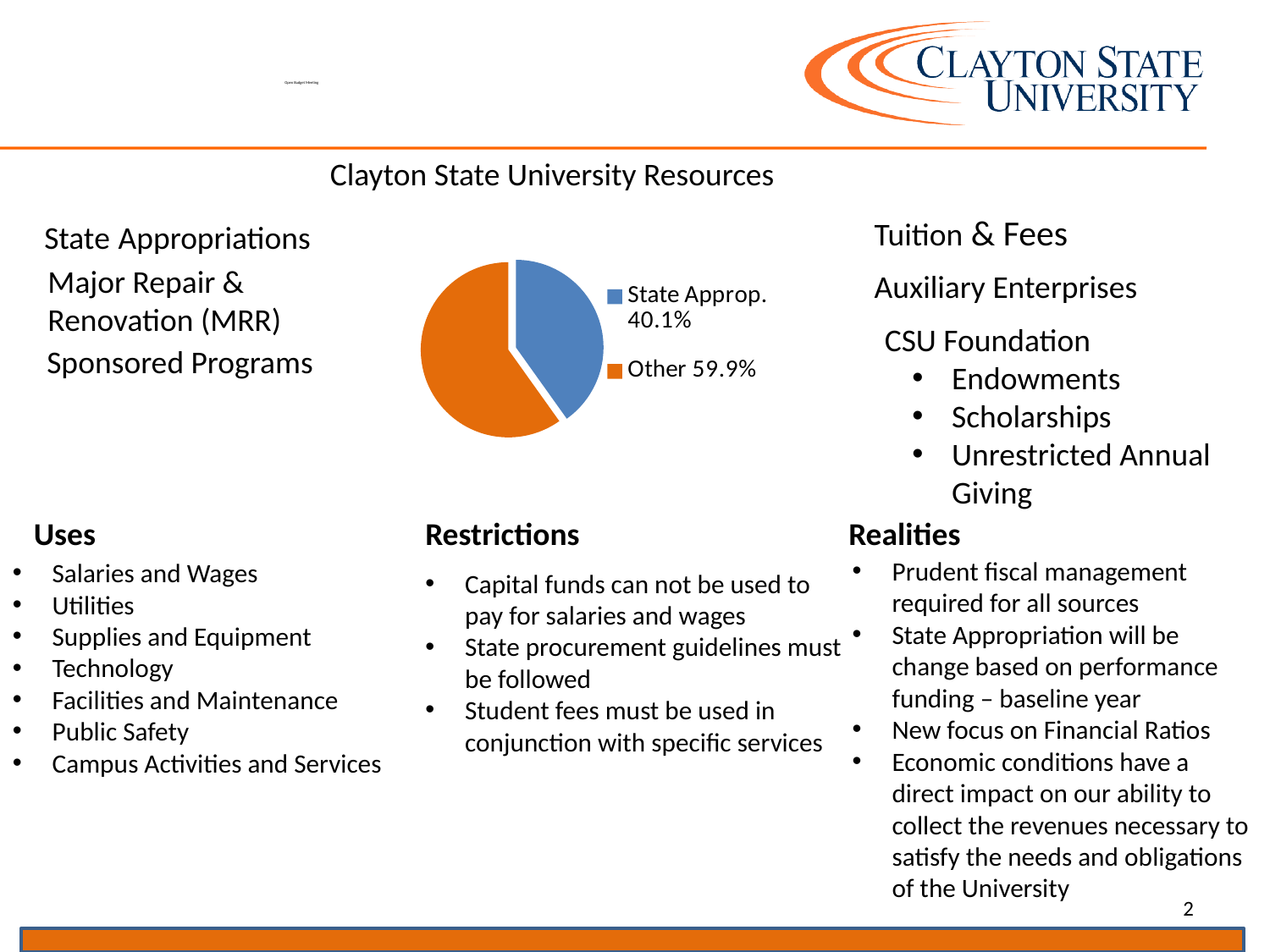
What colour is the Other slice in the pie chart? orange How many entries does the pie chart's legend list? 2 How many slices does the pie chart have? 2 Which slice of the pie chart is the largest? Other What share of the pie does Other represent? 59.9% What colour is the State Approp. slice in the pie chart? blue What is the difference in percentage points between the Other slice and the State Approp. slice? 19.8 Which is larger in the pie chart, State Approp. or Other? Other Which slice of the pie chart is the smallest? State Approp. What share of the pie does State Approp. represent? 40.1% What kind of chart is shown on the slide? pie chart Is the share for State Approp. greater or less than 50%? less